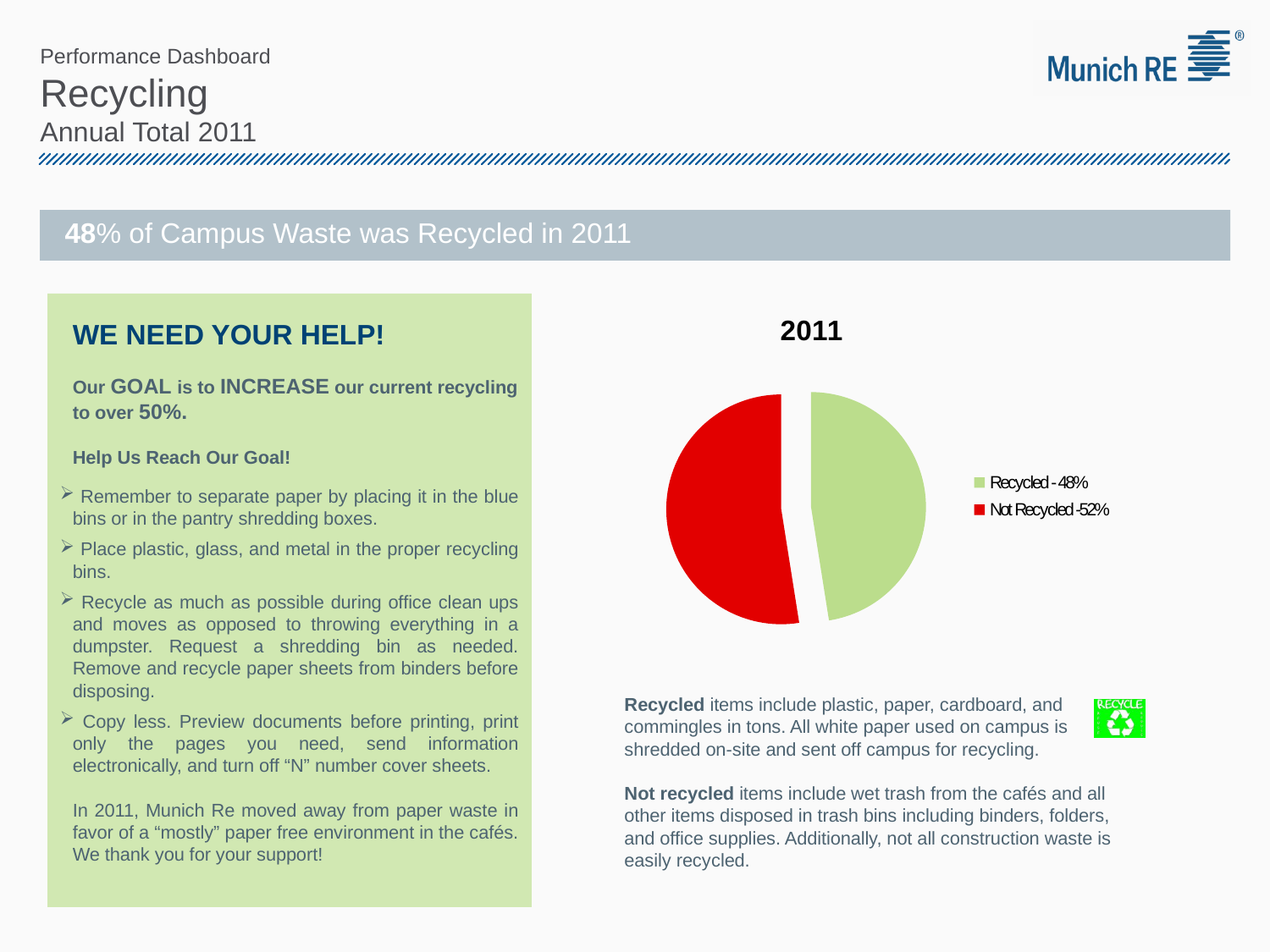
How many slices does the pie chart have? 2 What is the title of the pie chart? 2011 Which slice of the pie chart is larger, Recycled or Not Recycled? Not Recycled What is the difference in percentage points between the Not Recycled and Recycled shares? 4 Which category has the largest share of the pie? Not Recycled Which category has the smallest share of the pie? Recycled What share of the pie is Not Recycled? 52% What type of chart is shown on the slide? pie chart Is the Recycled share greater or less than 50%? less What colour is the Recycled slice in the pie chart? green What share of the pie is Recycled? 48% How many entries does the pie chart's legend list? 2